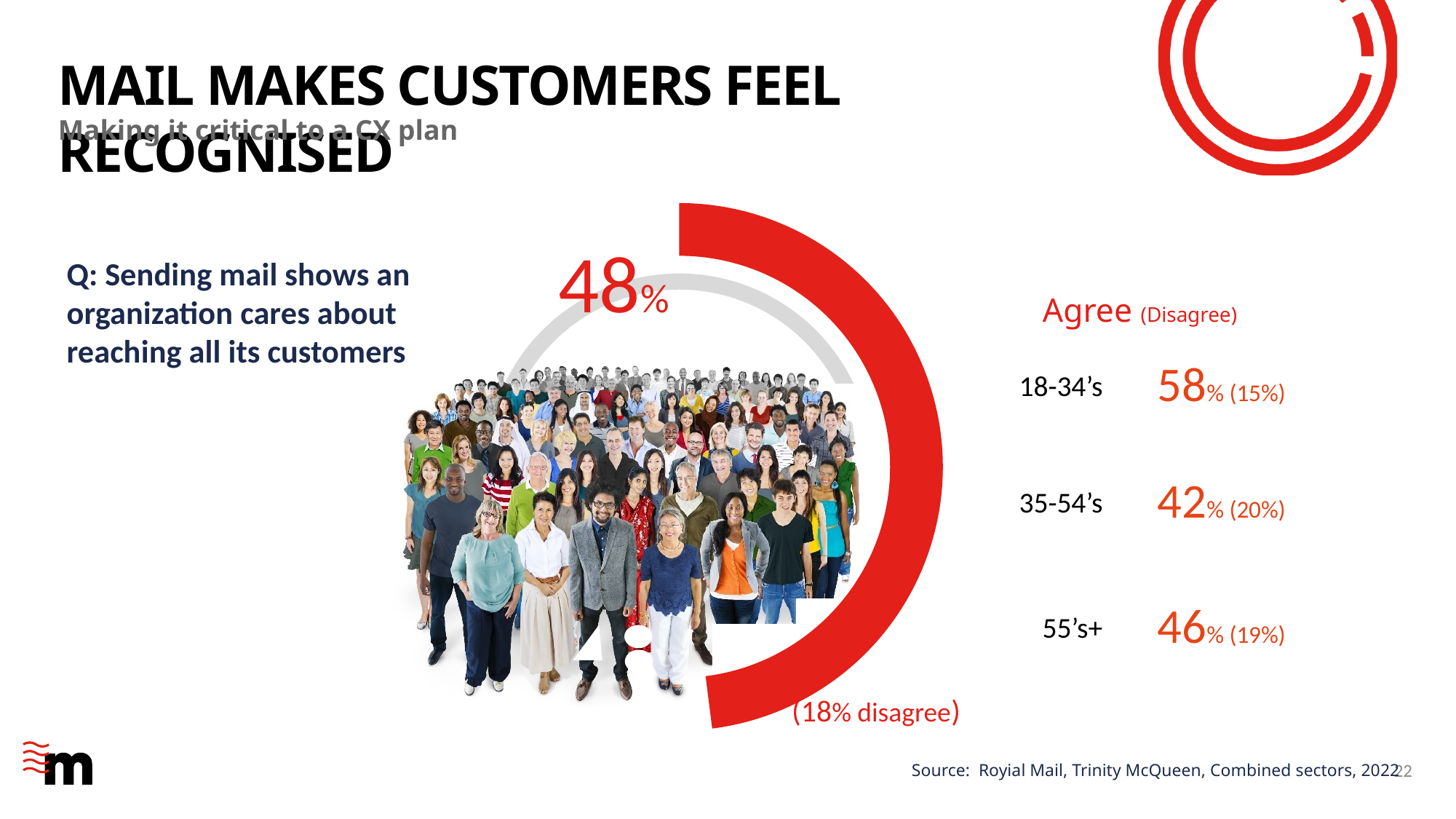
Is the agree share shown in the ring chart greater or less than 50%? less How many age groups are listed in the breakdown beside the chart? 3 What is the difference between the overall agree percentage (48%) and the overall disagree percentage (18%)? 30% What is the agree percentage for the 55's+ age group? 46% Which age group has the highest agree percentage in the breakdown to the right of the chart? 18-34's What kind of chart is used to display the 48% figure? Doughnut (ring) chart What is the disagree percentage for the 35-54's age group? 20% Which age group has the lowest agree percentage in the breakdown to the right of the chart? 35-54's Which is larger: the agree percentage for 18-34's or for 55's+? 18-34's What percentage of respondents agree that sending mail shows an organization cares about reaching all its customers, as shown in the ring chart? 48% What colour is the filled portion of the ring chart representing the 48% who agree? Red What percentage disagree, according to the label beneath the ring chart? 18% disagree